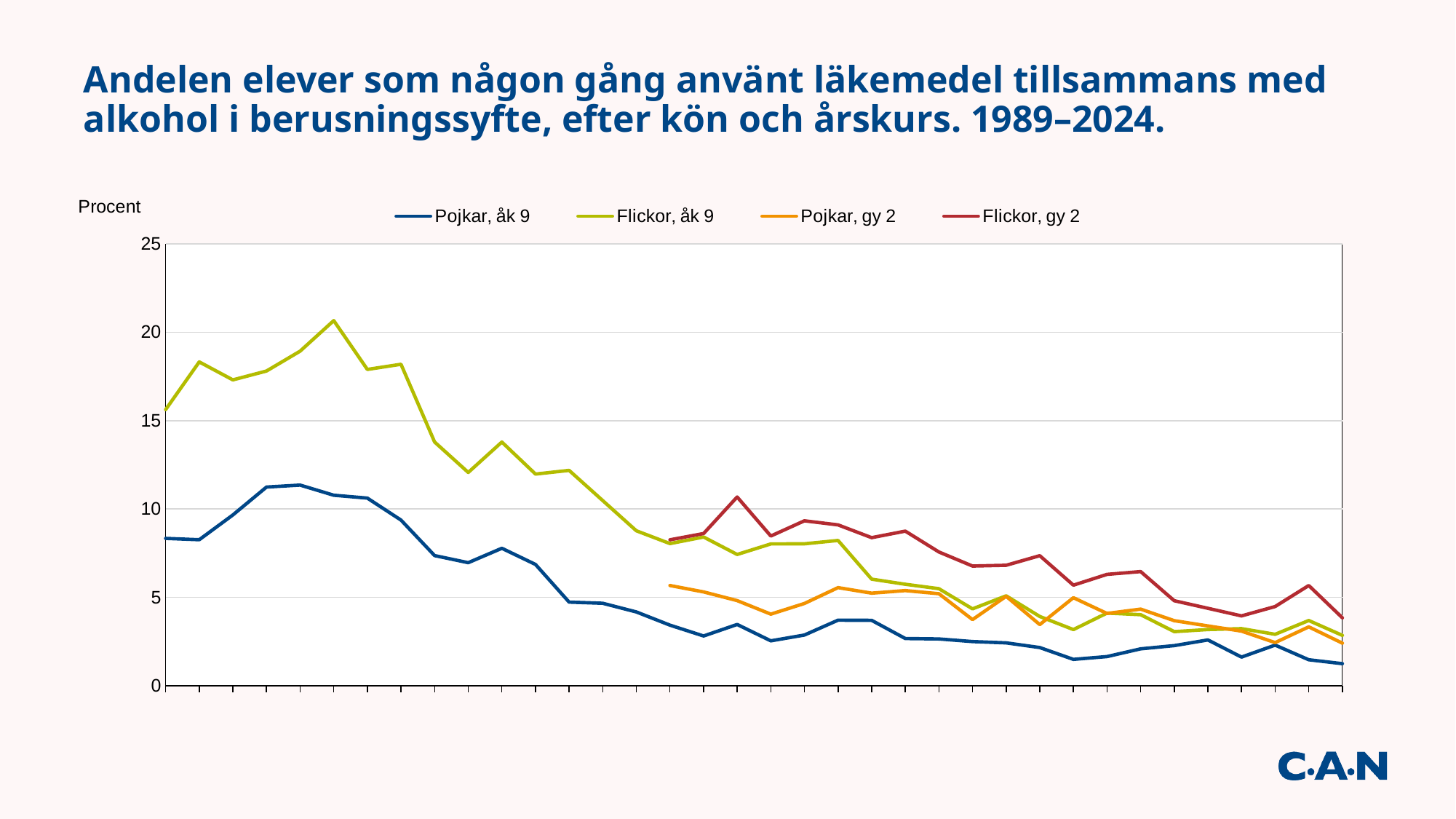
Is the peak value of the Flickor, åk 9 series greater or less than 15? greater Is the final value of the Pojkar, åk 9 series greater or less than 5? less Which series reaches the highest value anywhere on the chart? Flickor, åk 9 What is the highest value shown on the y axis? 25 Does the Flickor, åk 9 series rise or fall overall from left to right? Fall What kind of chart is shown on the slide? Line chart Is the peak value of the Pojkar, åk 9 series greater or less than 10? greater Does the Pojkar, åk 9 series rise or fall overall from left to right? Fall Which series has the lowest value at the right-hand end of the chart? Pojkar, åk 9 How many series does the legend list? 4 What unit is shown on the y axis? Procent At the left-hand start of the chart, which is larger: Flickor, åk 9 or Pojkar, åk 9? Flickor, åk 9